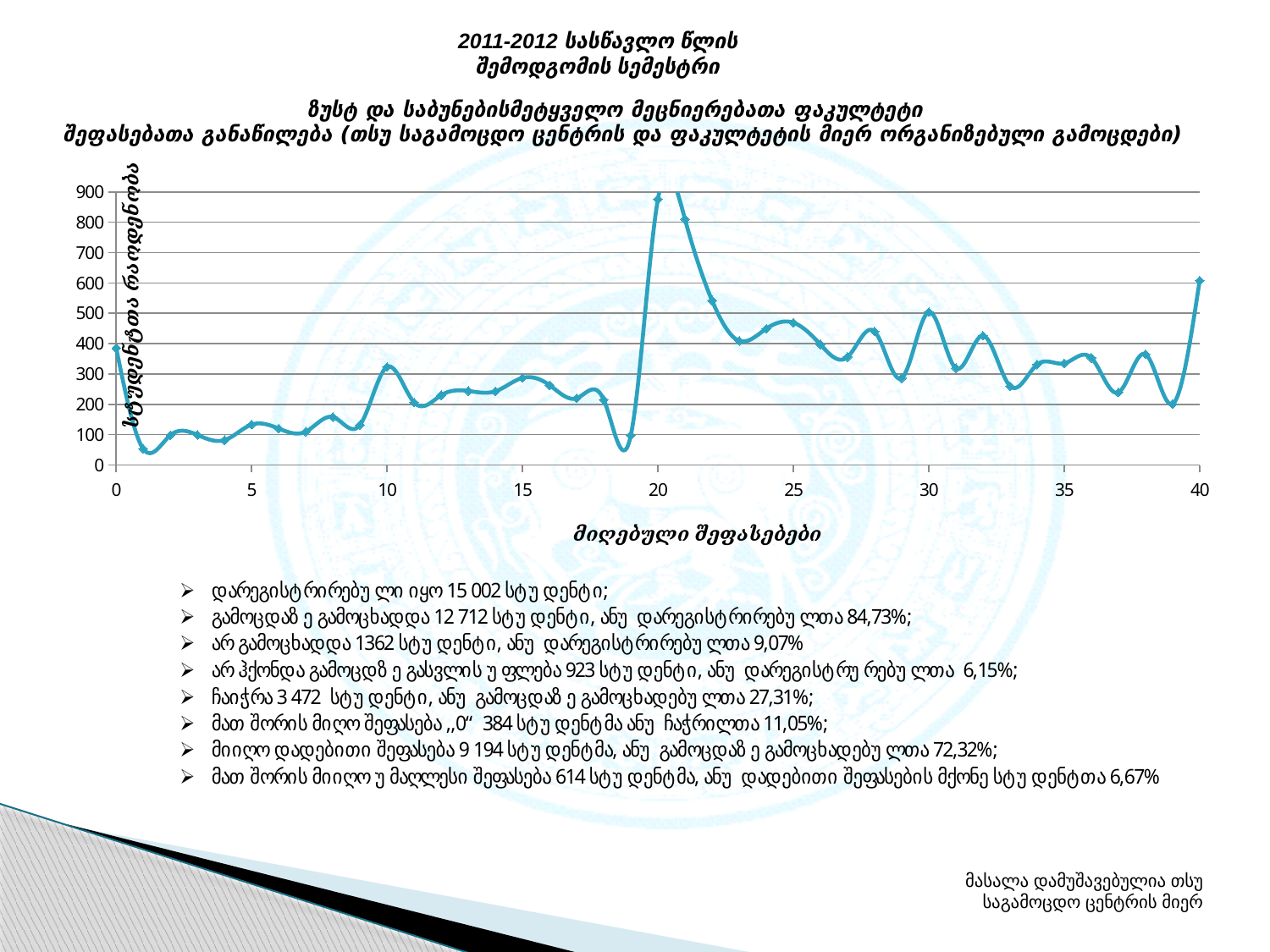
Is the number of students for grade 40 greater or less than 500? greater Is the number of students for grade 20 greater or less than 800? greater Is the number of students for grade 5 greater or less than 100? greater Which has more students, grade 20 or grade 21? grade 20 Do the values rise or fall along the x axis between grade 20 and grade 23? fall What is the title of the x axis? მიღებული შეფასებები What kind of chart is shown on the slide? line chart Which has more students, grade 10 or grade 5? grade 10 At which received grade (x-axis value) does the number of students reach its highest point? 20